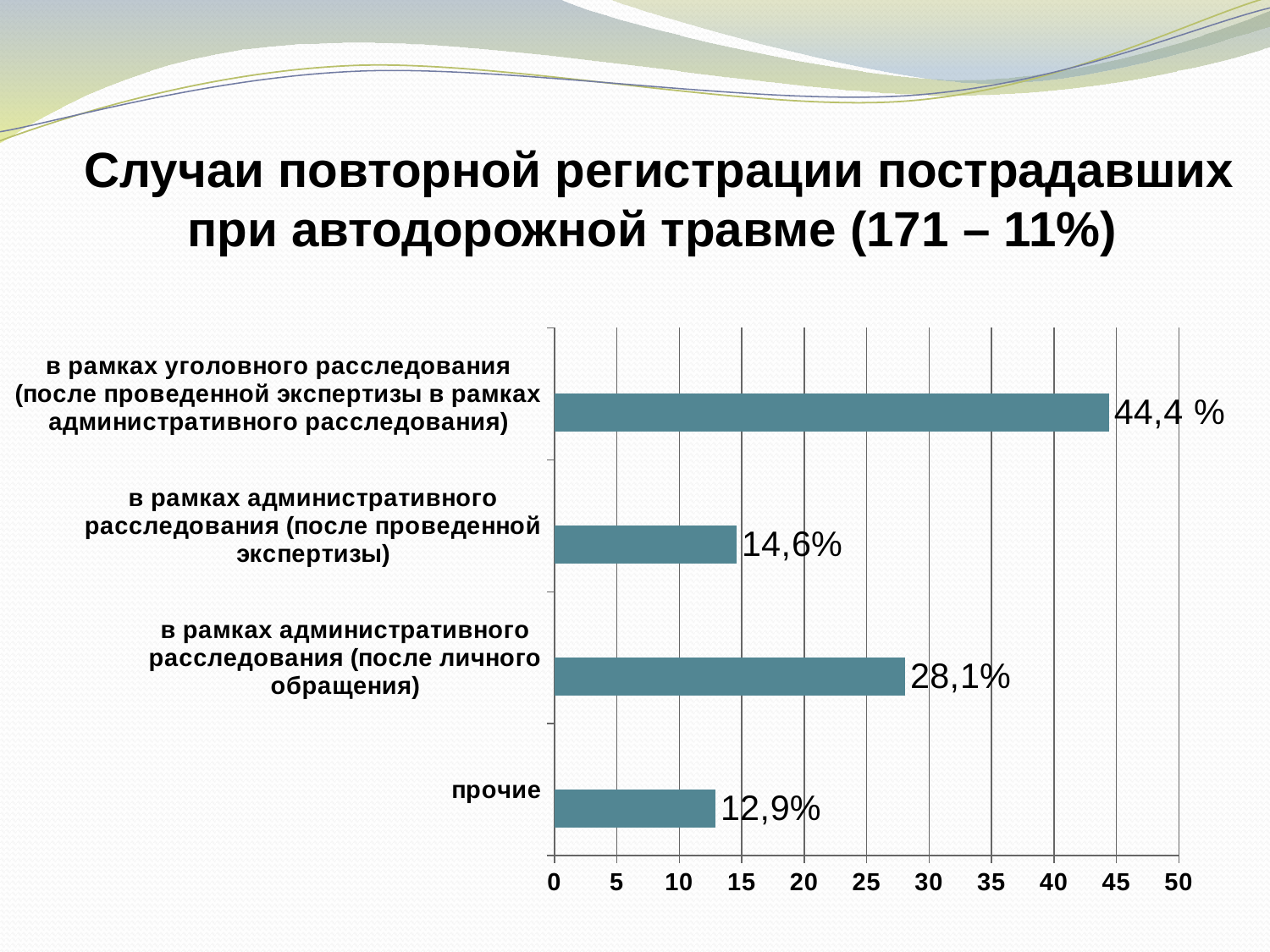
Which category has the lowest value? прочие What is the value for «прочие»? 12,9% Is the value for «в рамках уголовного расследования» greater or less than 40? greater Which is larger: the value for «в рамках административного расследования (после личного обращения)» or the value for «в рамках административного расследования (после проведенной экспертизы)»? в рамках административного расследования (после личного обращения) What is the value for «в рамках уголовного расследования (после проведенной экспертизы в рамках административного расследования)»? 44,4 % What is the value for «в рамках административного расследования (после проведенной экспертизы)»? 14,6% What kind of chart is shown on the slide? bar chart What is the difference between the value for «в рамках уголовного расследования» and the value for «в рамках административного расследования (после личного обращения)»? 16,3 What is the value for «в рамках административного расследования (после личного обращения)»? 28,1% What is the difference between the value for «в рамках административного расследования (после проведенной экспертизы)» and the value for «прочие»? 1,7 How many categories are shown in the chart? 4 Which category has the highest value? в рамках уголовного расследования (после проведенной экспертизы в рамках административного расследования)